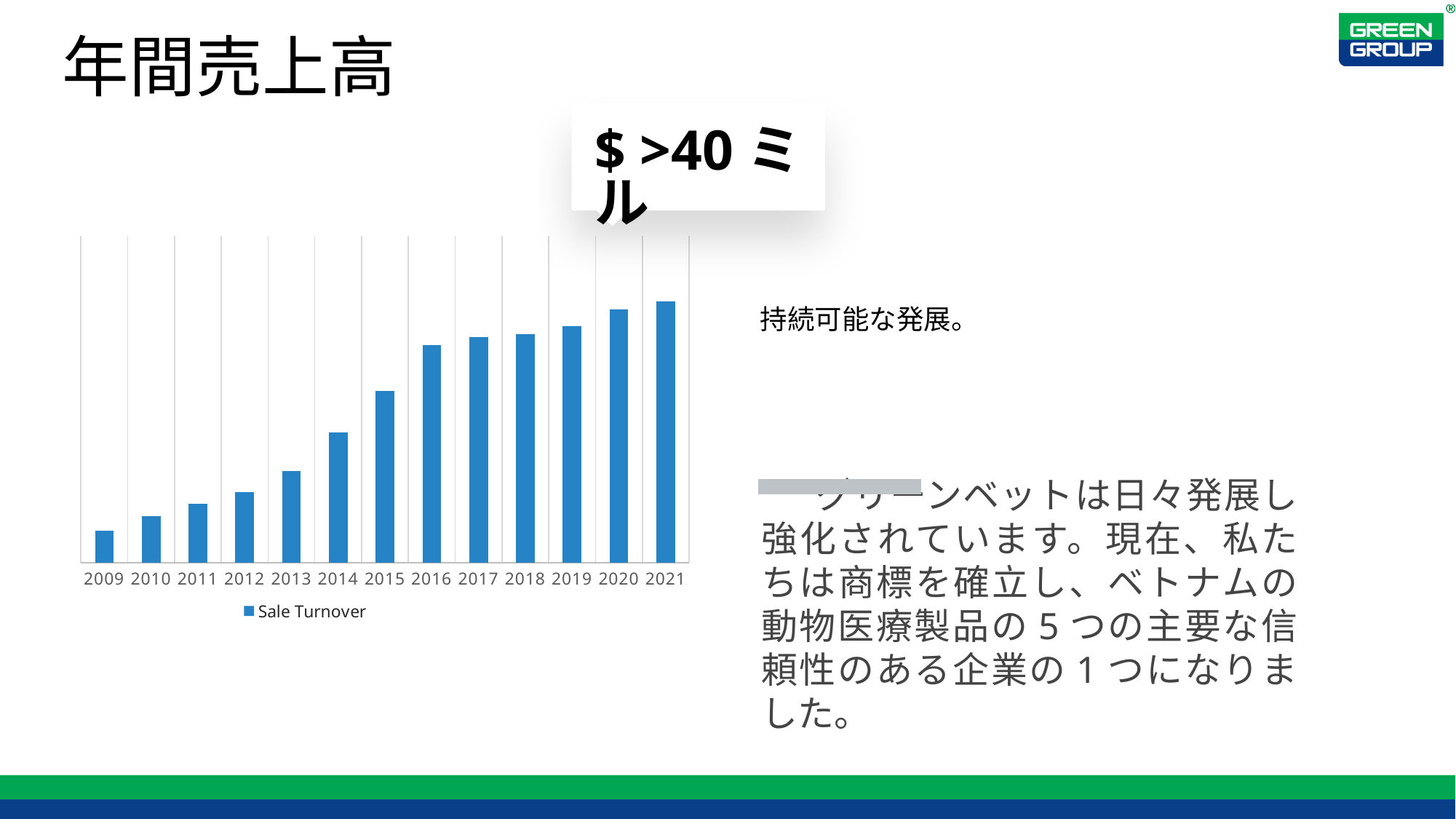
How many years are shown on the x axis of the chart? 13 What kind of chart is shown on the slide? bar chart Which year has the larger Sale Turnover bar, 2014 or 2020? 2020 How many series does the chart legend list? 1 Do the Sale Turnover values rise or fall from 2009 to 2021? rise What is the first year shown on the x axis of the chart? 2009 Which year has the highest Sale Turnover bar? 2021 Which year has the larger Sale Turnover bar, 2013 or 2015? 2015 Which year has the lowest Sale Turnover bar? 2009 What is the name of the series shown in the chart legend? Sale Turnover Which year has the larger Sale Turnover bar, 2010 or 2016? 2016